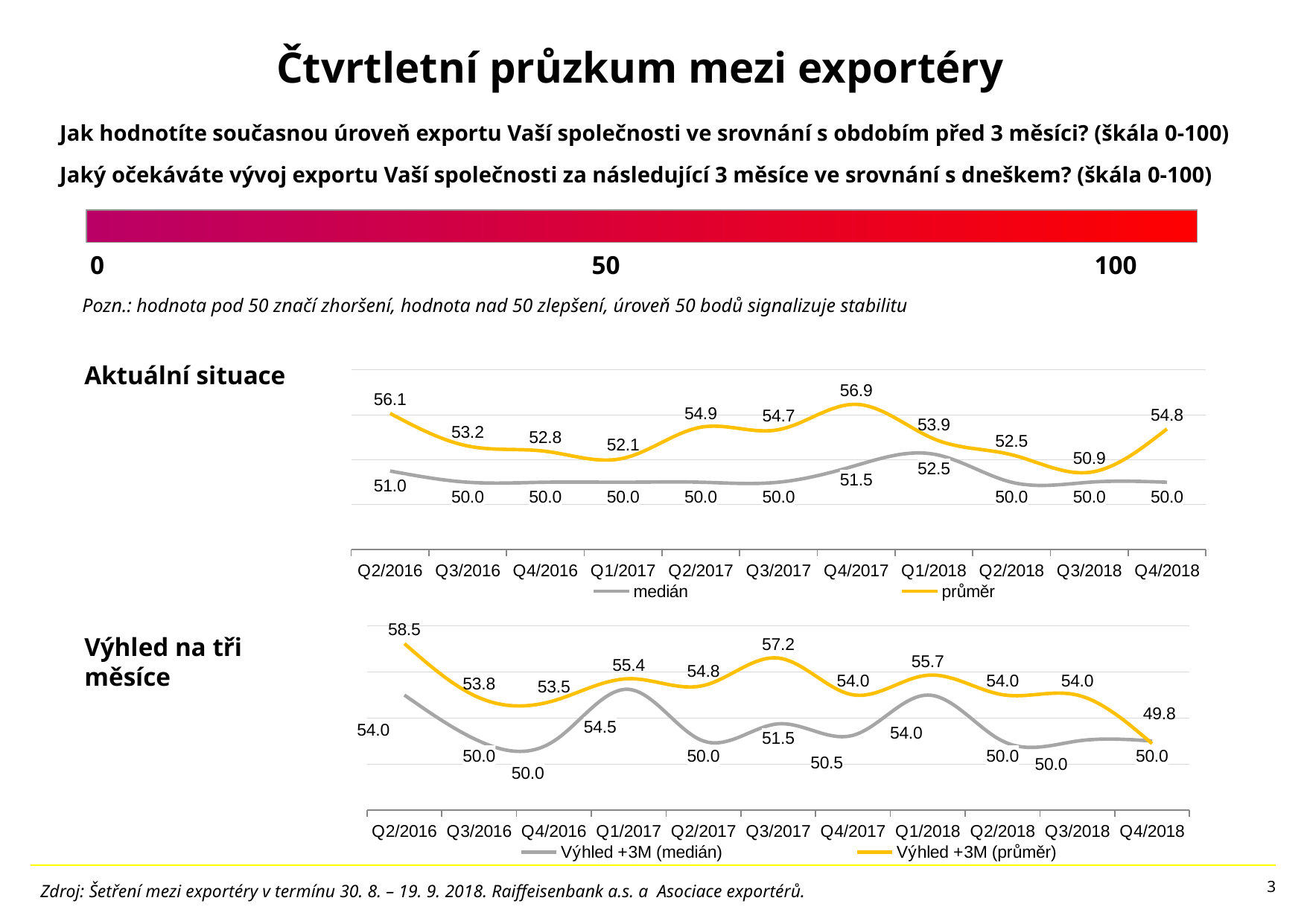
In the 'Výhled na tři měsíce' chart, what is the Výhled +3M (průměr) value for Q3/2017? 57.2 In the 'Aktuální situace' chart, how many quarters are shown on the x axis? 11 In the 'Aktuální situace' chart, what is the medián value for Q1/2018? 52.5 In the 'Aktuální situace' chart, what is the průměr value for Q4/2017? 56.9 In the 'Aktuální situace' chart, which quarter has the lowest průměr value? Q3/2018 What type of chart is the 'Aktuální situace' chart? Line chart In the 'Výhled na tři měsíce' chart, what is the Výhled +3M (medián) value for Q1/2017? 54.5 In the 'Výhled na tři měsíce' chart, which quarter has the highest Výhled +3M (průměr) value? Q2/2016 In the 'Aktuální situace' chart, what is the difference between the průměr values for Q2/2016 and Q3/2018? 5.2 In the 'Výhled na tři měsíce' chart, what is the difference between the Výhled +3M (průměr) values for Q2/2016 and Q4/2018? 8.7 How many series does the legend of the 'Výhled na tři měsíce' chart list? 2 In the 'Výhled na tři měsíce' chart, which is larger for Q4/2018: Výhled +3M (průměr) or Výhled +3M (medián)? Výhled +3M (medián)